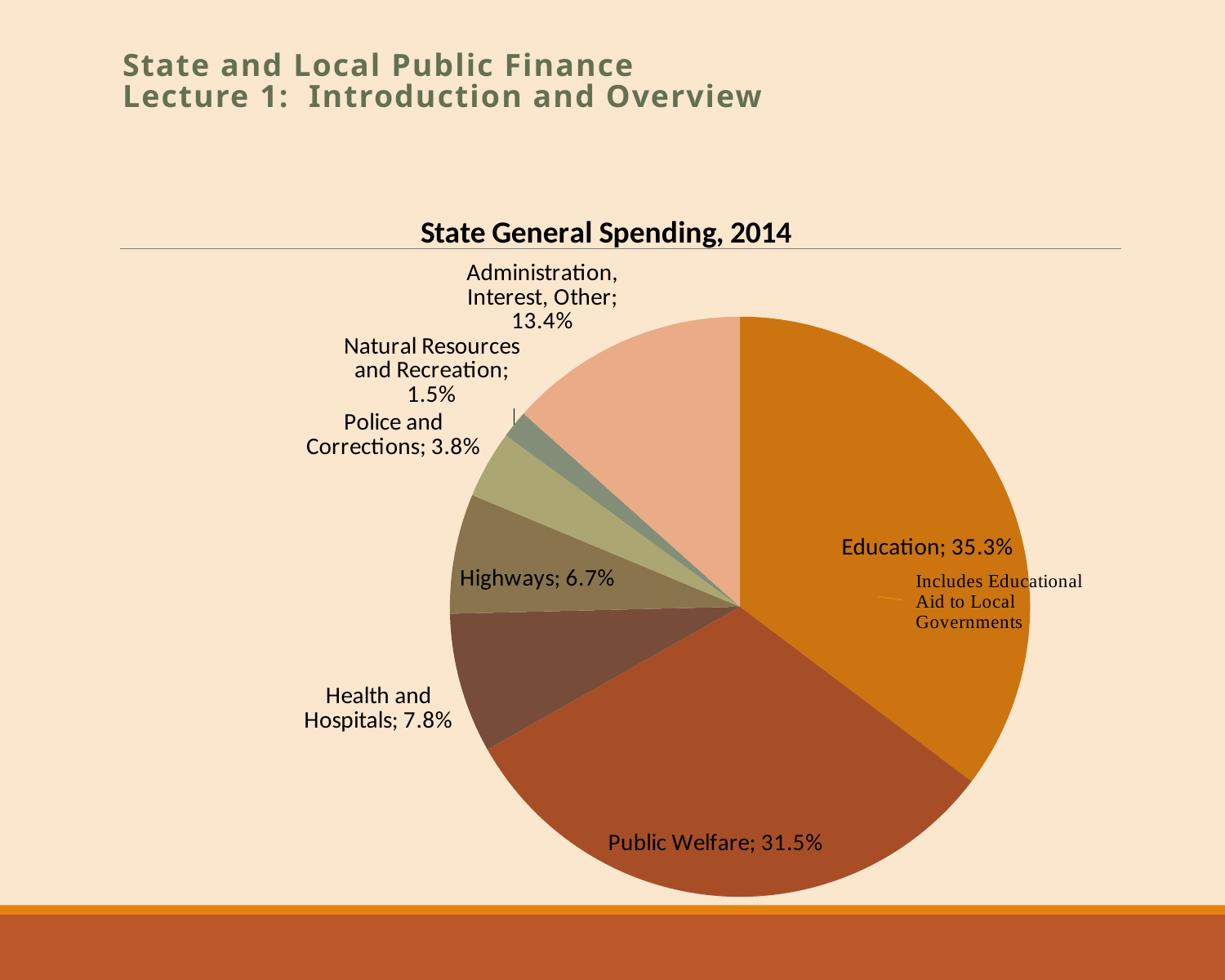
What percentage is shown for Health and Hospitals? 7.8% What is the difference in percentage points between Education and Public Welfare? 3.8 What share of state general spending in 2014 goes to Education? 35.3% What percentage is shown for Administration, Interest, Other? 13.4% Which category has the largest share of state general spending? Education What share of state general spending in 2014 goes to Public Welfare? 31.5% What percentage is shown for Highways? 6.7% Which is larger, the share for Health and Hospitals or the share for Highways? Health and Hospitals What is the title of the chart? State General Spending, 2014 How many categories are shown in the pie chart? 7 Which category has the smallest share of state general spending? Natural Resources and Recreation What kind of chart is shown on the slide? Pie chart